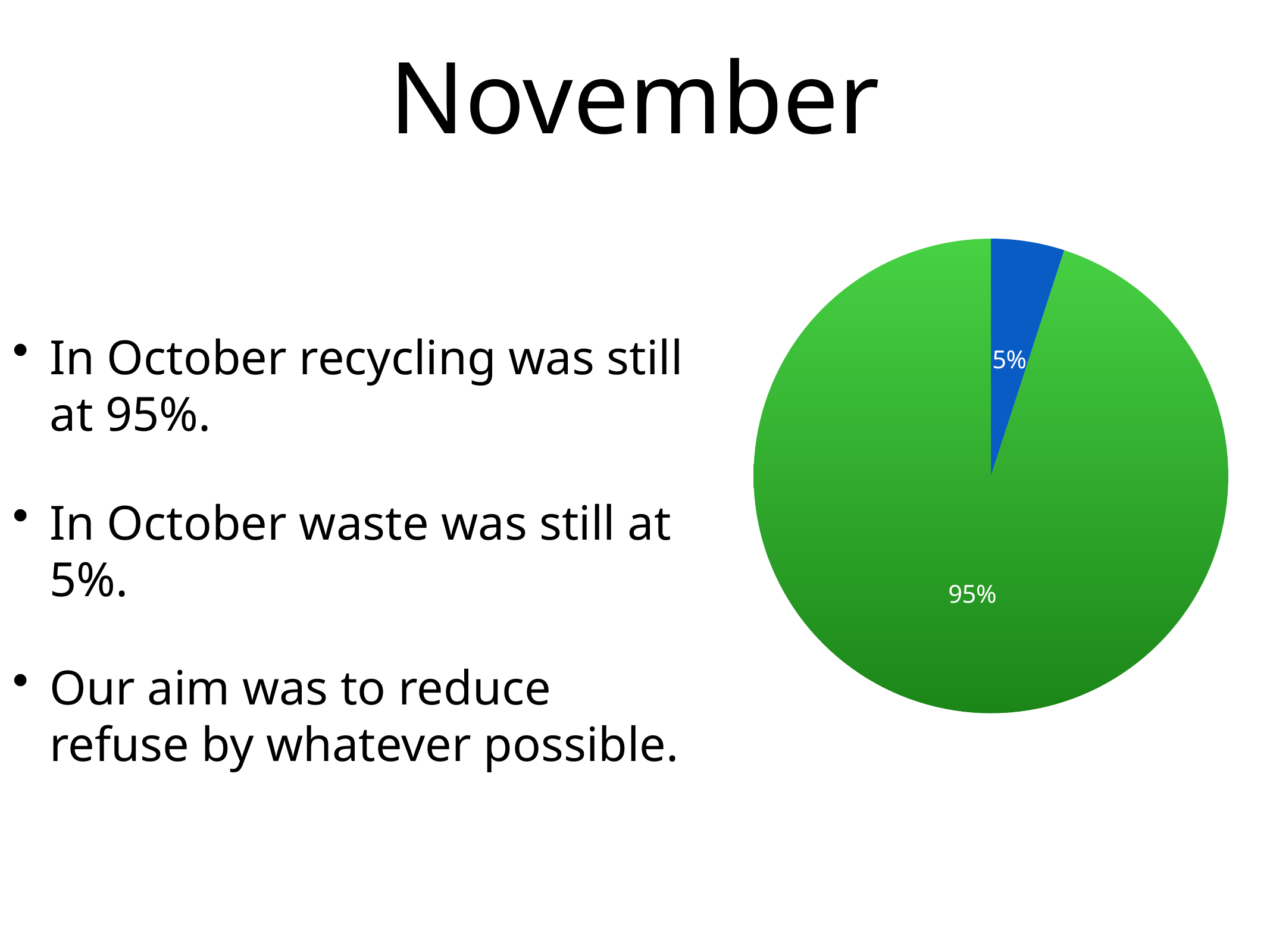
Which slice of the pie chart is the largest? the green slice (95%) What is the difference between the two slice values in the pie chart? 90% Is the value of the green slice greater or less than 50%? greater How many slices does the pie chart have? 2 What share of the pie does the blue slice represent? 5% What value is labelled on the blue slice of the pie chart? 5% Is the green slice or the blue slice larger in the pie chart? the green slice What kind of chart is shown on the slide? pie chart What colour is the slice labelled 5%? blue What value is labelled on the green slice of the pie chart? 95% What share of the pie does the green slice represent? 95% Which slice of the pie chart is the smallest? the blue slice (5%)